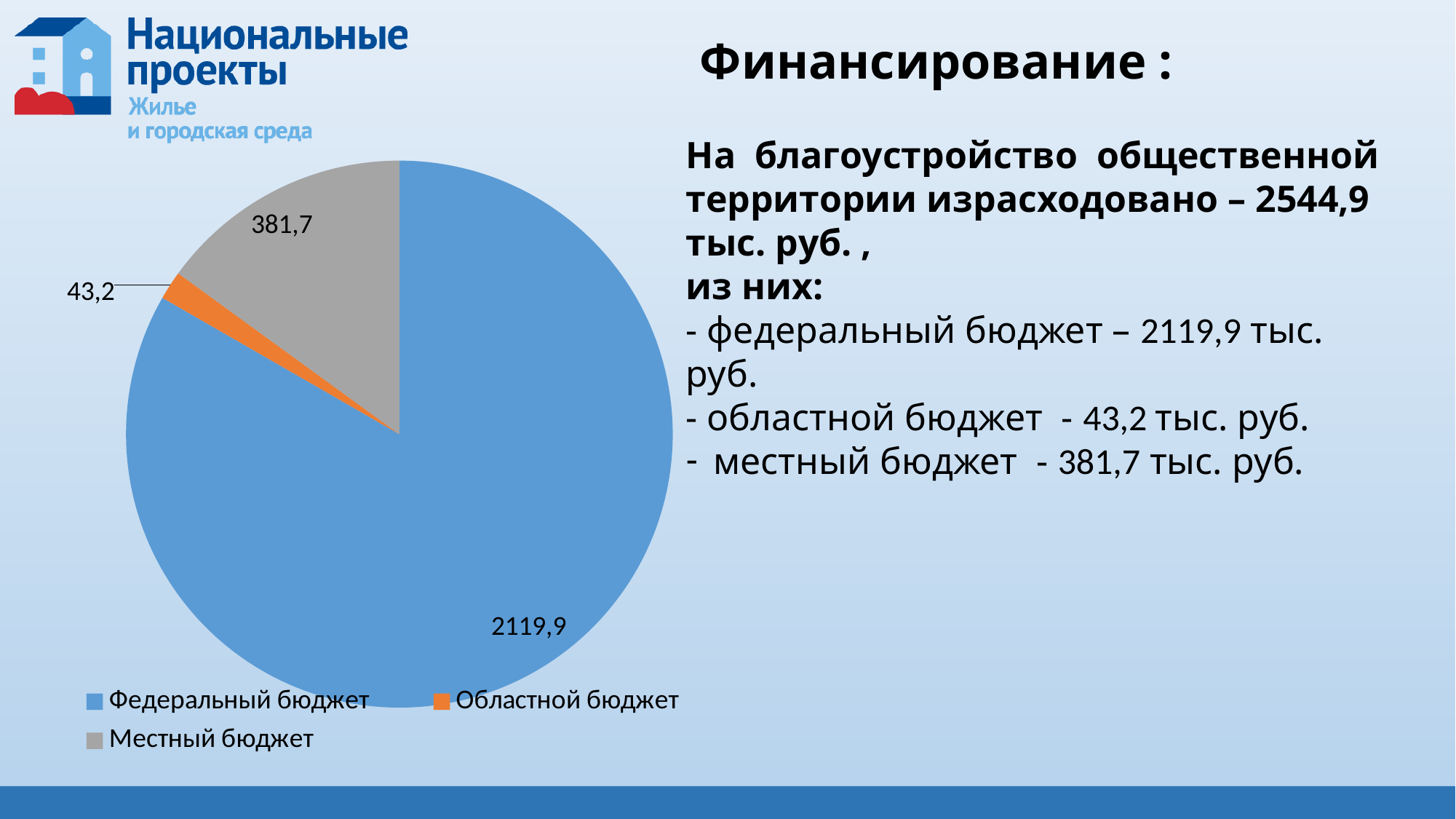
What is the total of all slices in the pie chart? 2544,9 Which is larger: Местный бюджет or Областной бюджет? Местный бюджет What is the value for Областной бюджет in the pie chart? 43,2 What is the difference between the values for Местный бюджет and Областной бюджет? 338,5 What is the value for Местный бюджет in the pie chart? 381,7 What is the value for Федеральный бюджет in the pie chart? 2119,9 Which category has the smallest slice in the pie chart? Областной бюджет What type of chart is shown on the slide? Pie chart What is the difference between the values for Федеральный бюджет and Местный бюджет? 1738,2 Which category has the largest slice in the pie chart? Федеральный бюджет How many slices does the pie chart have? 3 What colour is the slice for Областной бюджет? Orange